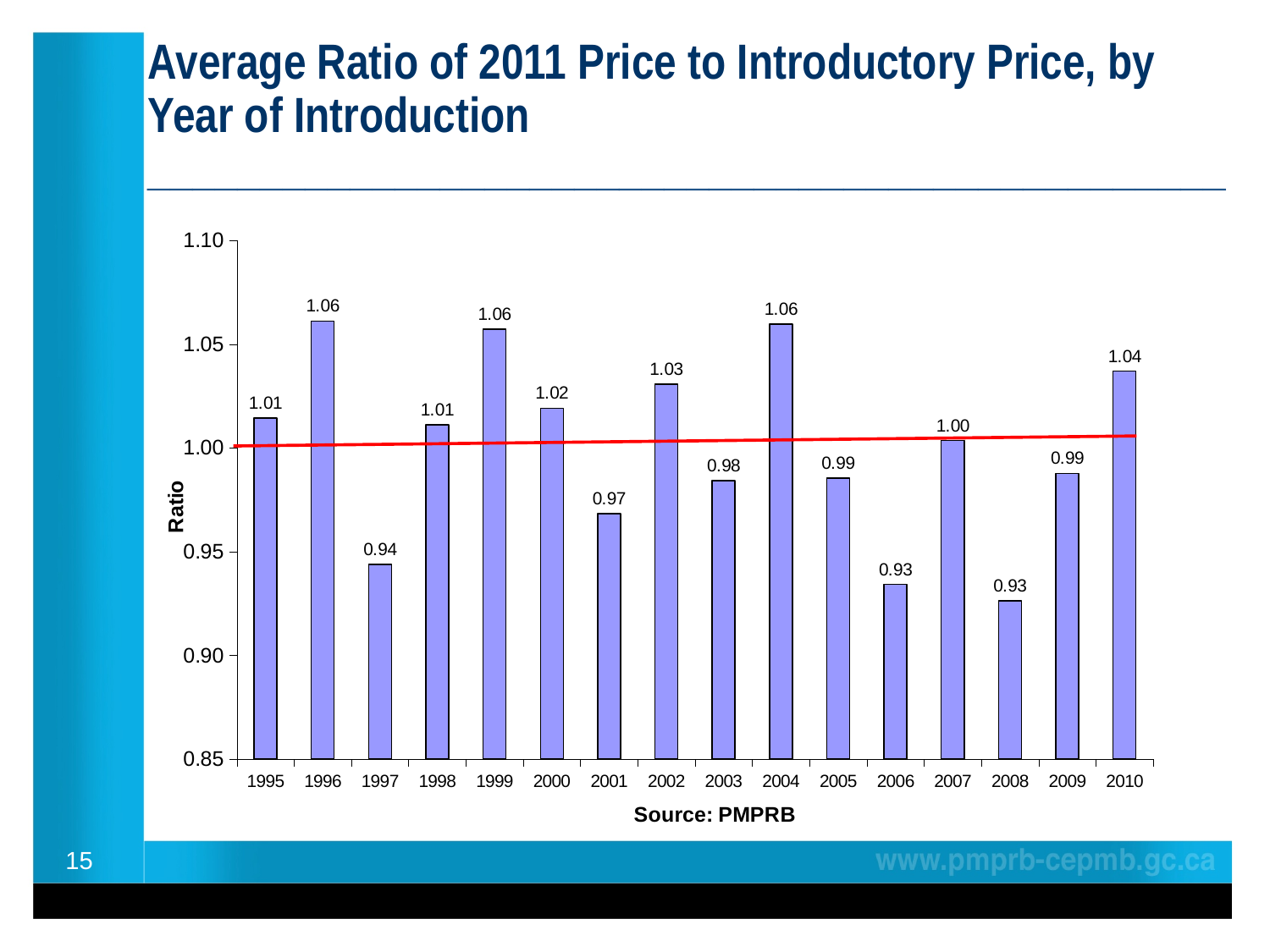
Which year has the larger ratio, 2001 or 2003? 2003 Is the value for 2006 greater or less than 0.95? less What is the ratio value for 2002? 1.03 How many years of introduction are shown on the x axis? 16 What kind of chart is shown on the slide? bar chart What is the ratio value for 2010? 1.04 What is the ratio value for 2007? 1.00 What is the ratio value for 1997? 0.94 Which year has the larger ratio, 2000 or 2005? 2000 What is the label on the vertical axis of the chart? Ratio What is the difference between the ratio for 2010 and the ratio for 2008? 0.11 What is the difference between the ratio for 1996 and the ratio for 1997? 0.12